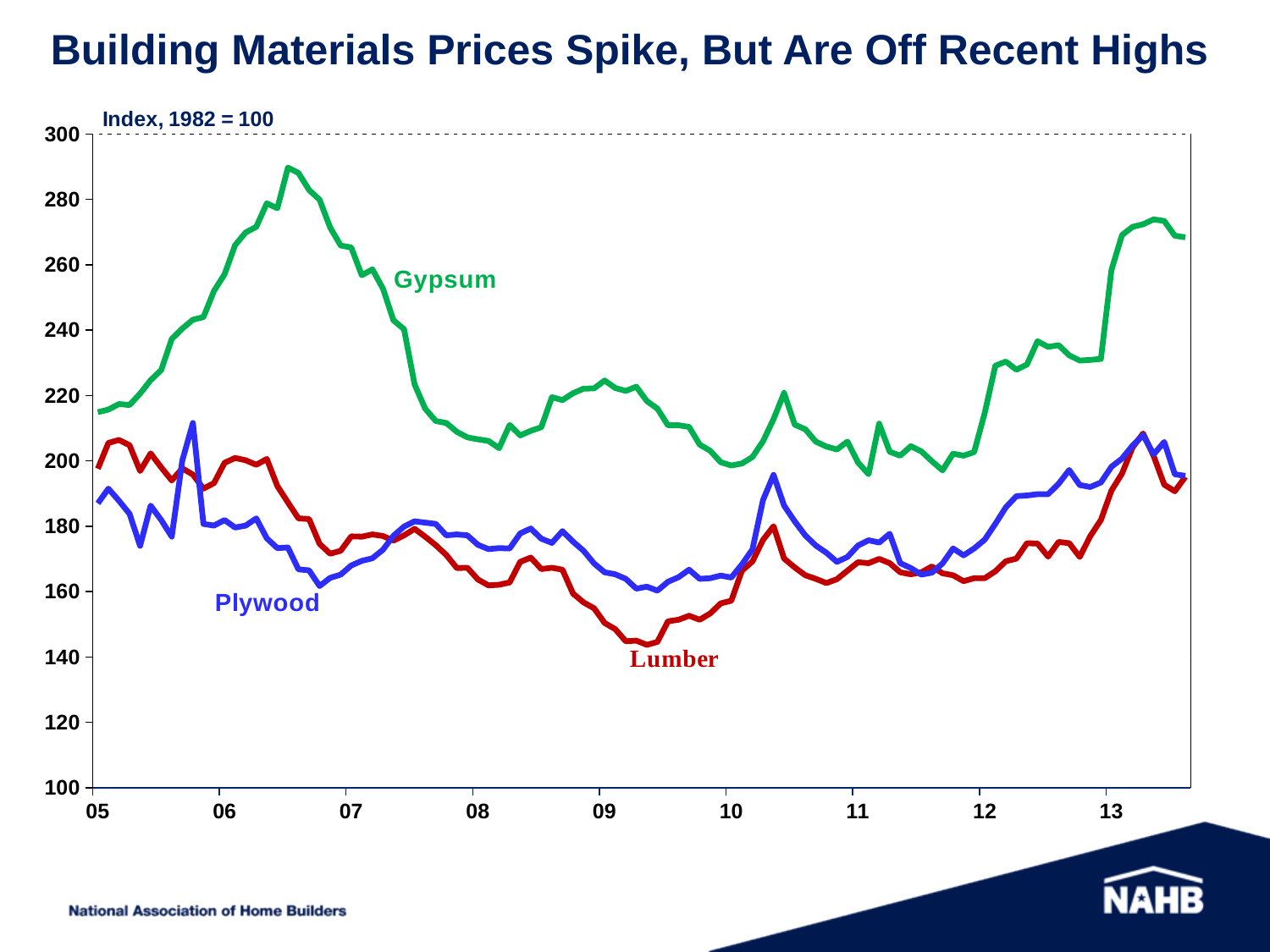
Does the Gypsum series rise or fall from 2012 to 2013? rise Is the lowest value for Lumber in 2009 greater or less than 150? less Is the value for Gypsum in mid-2013 greater or less than 260? greater Which series has the highest values across the whole period shown? Gypsum Does the Gypsum series rise or fall between its 2006 peak and 2008? fall What is the title of the chart? Building Materials Prices Spike, But Are Off Recent Highs Which series has the lowest value in 2009? Lumber Is the lowest value for Plywood in late 2006 greater or less than 180? less How many series are plotted on the chart? 3 What kind of chart is shown on the slide? line chart